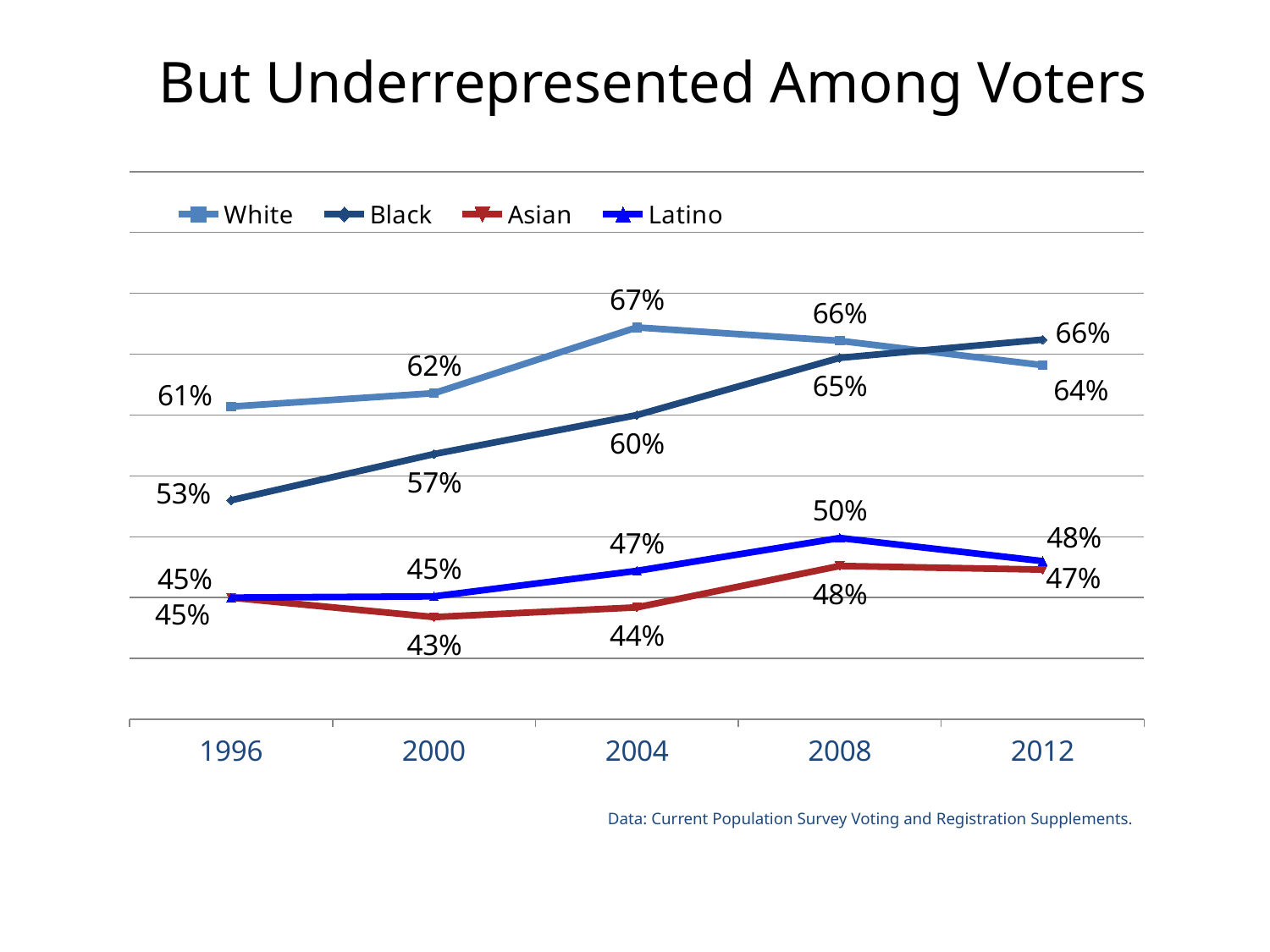
What is the value for Latino in 2008? 50% What type of chart is shown on the slide? line chart In which year is the Black series lowest? 1996 What is the difference between the White and Black values in 1996? 8% What is the value for Asian in 2000? 43% What is the value for White in 2004? 67% How many years are shown on the x axis? 5 In which year is the White series highest? 2004 Does the Black series rise or fall from 1996 to 2012? rise What is the value for Black in 1996? 53% How many series does the legend list? 4 Which is larger in 2012, the Black value or the White value? Black